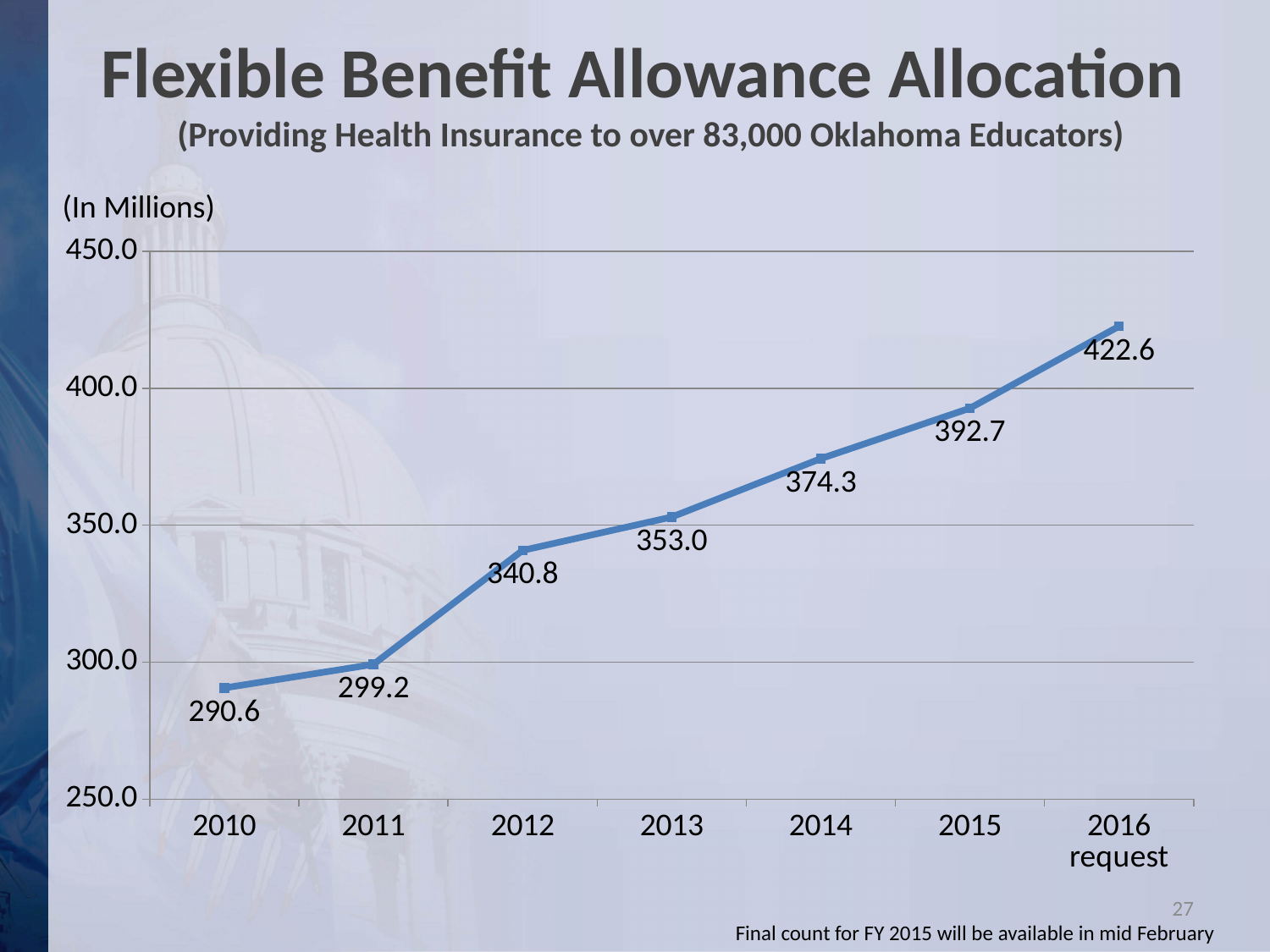
What is the value for 2010? 290.6 What is the value for the 2016 request? 422.6 Which is larger, the value for 2014 or the value for 2015? 2015 What kind of chart is shown on the slide? line chart What is the value for 2013? 353.0 Is the value for 2011 greater or less than 300.0? less What is the difference between the 2012 and 2011 values? 41.6 Do the values rise or fall from 2010 to the 2016 request? rise How many data points are plotted on the chart? 7 Which year has the lowest value? 2010 Which year has the highest value? 2016 request What is the difference between the 2016 request and the 2010 value? 132.0